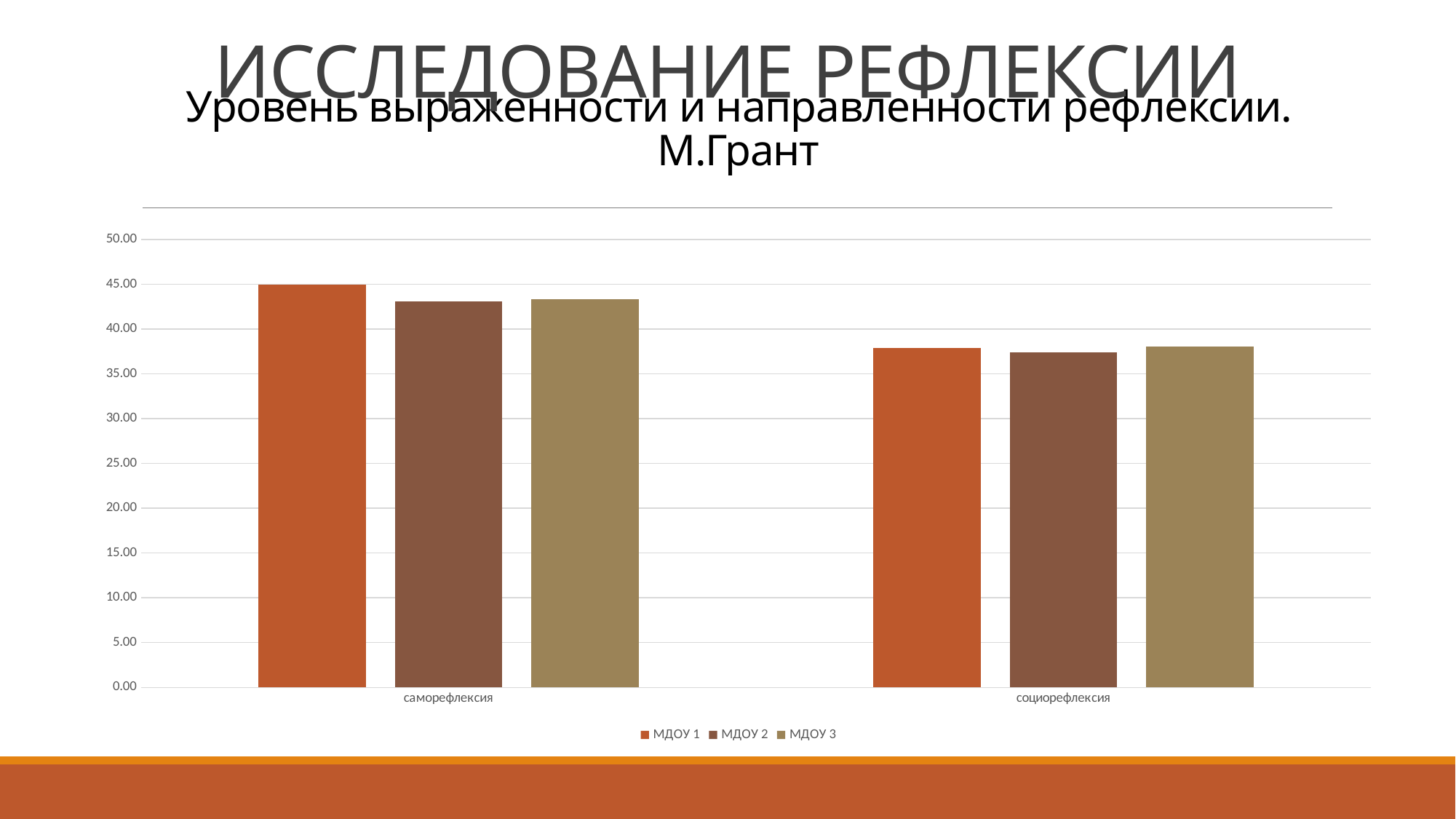
What kind of chart is shown on the slide? bar chart Do the values for МДОУ 2 rise or fall from саморефлексия to социорефлексия? fall How many categories are shown on the x axis of the chart? 2 Which series has the highest value for саморефлексия? МДОУ 1 Is the value of МДОУ 2 for саморефлексия greater or less than 40.00? greater Which is larger for МДОУ 1: the value for саморефлексия or the value for социорефлексия? саморефлексия How many series does the chart legend list? 3 What is the highest value shown on the vertical axis of the chart? 50.00 Which series are listed in the chart legend? МДОУ 1, МДОУ 2, МДОУ 3 Is the value of МДОУ 1 for саморефлексия greater or less than 40.00? greater Is the value of МДОУ 1 for социорефлексия greater or less than 40.00? less